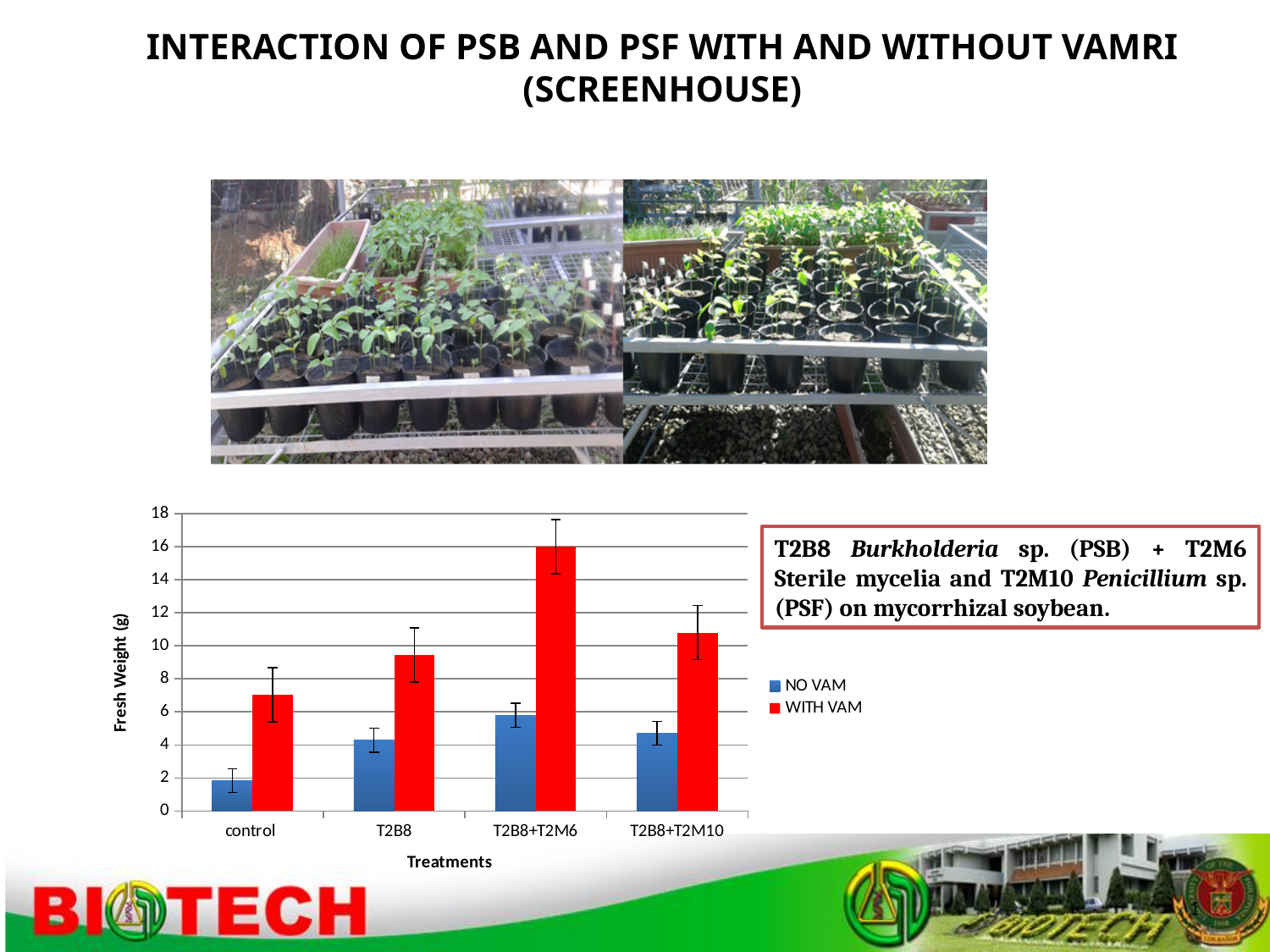
What type of chart is shown on the slide? bar chart Which treatment has the highest WITH VAM fresh weight? T2B8+T2M6 For the control treatment, which is larger: the NO VAM value or the WITH VAM value? WITH VAM Is the NO VAM value for control greater or less than 4? less What is the label of the y axis of the chart? Fresh Weight (g) Is the WITH VAM value for T2B8+T2M6 greater or less than 14? greater Which treatment has the lowest NO VAM fresh weight? control Which treatment has the lowest WITH VAM fresh weight? control Is the WITH VAM value for T2B8 greater or less than 8? greater How many series does the chart legend list? 2 How many treatment categories are shown on the x axis of the chart? 4 Which is larger: the NO VAM value for T2B8+T2M6 or the NO VAM value for control? T2B8+T2M6